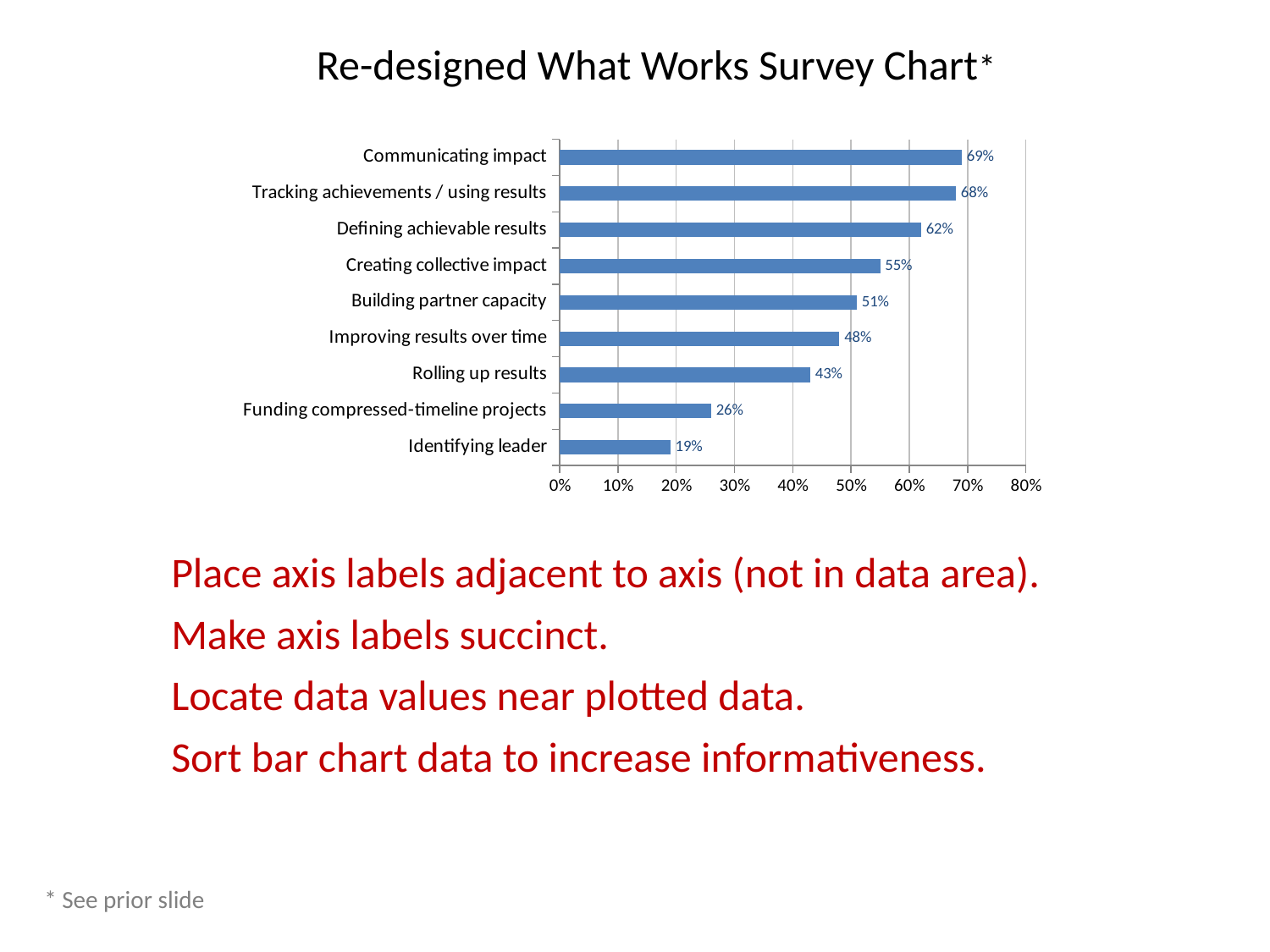
What is the value for Communicating impact? 69% Is the value for Identifying leader greater or less than 20%? less What is the title of the chart on the slide? Re-designed What Works Survey Chart What is the difference between Communicating impact and Identifying leader? 50% How many categories are shown in the chart? 9 Which category has the lowest value? Identifying leader Which is larger, Building partner capacity or Improving results over time? Building partner capacity What is the difference between Defining achievable results and Creating collective impact? 7% What kind of chart is shown on the slide? Bar chart What is the value for Rolling up results? 43% What is the value for Funding compressed-timeline projects? 26% Which category has the highest value? Communicating impact